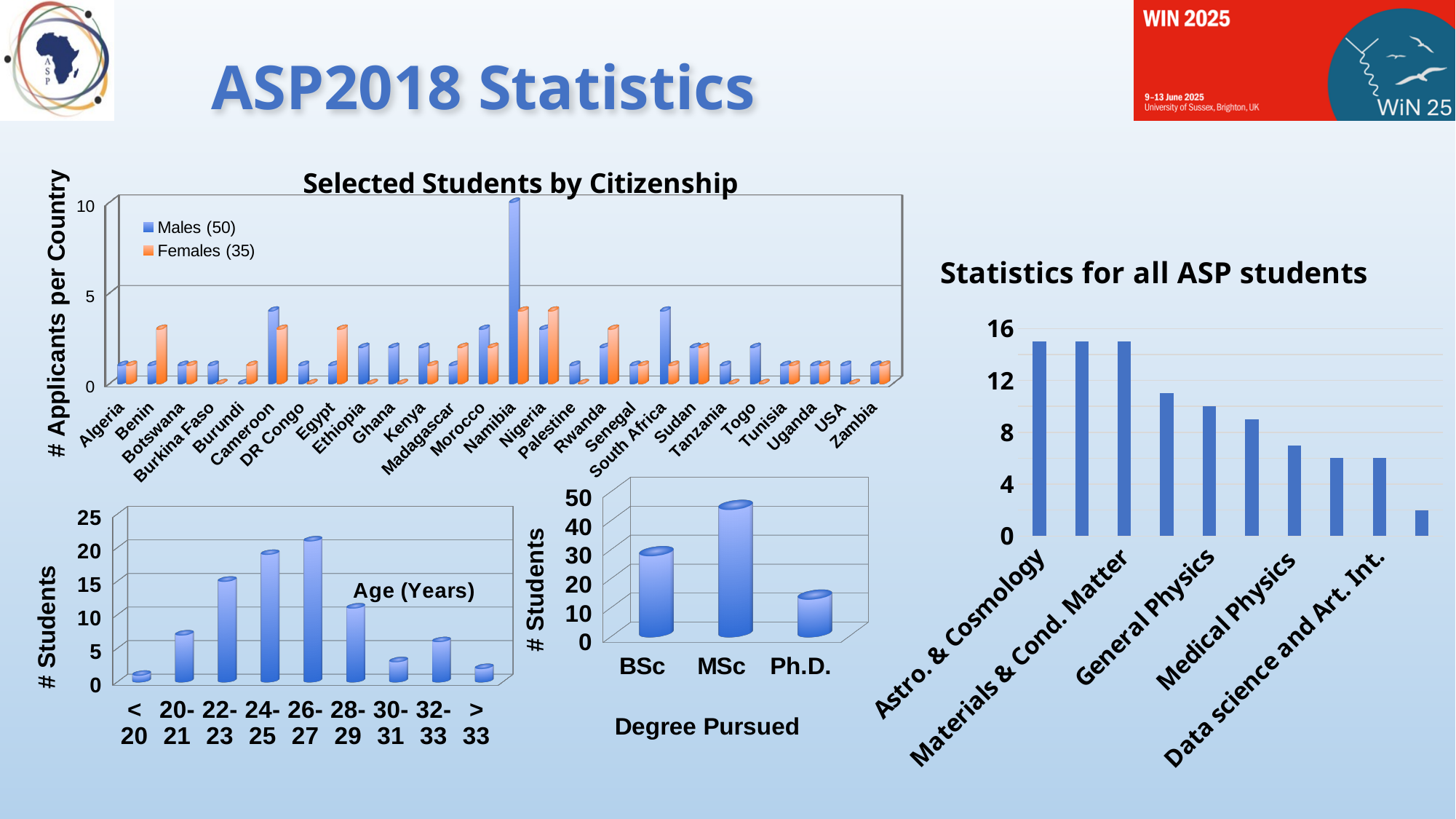
In the 'Degree Pursued' chart, which degree has the most students? MSc What kind of chart is 'Statistics for all ASP students'? bar chart In the age chart at the bottom left, which age group has the most students? 26-27 In 'Selected Students by Citizenship', what are the two legend entries? Males (50) and Females (35) What kind of chart is 'Selected Students by Citizenship'? bar chart In 'Selected Students by Citizenship', which country has the highest number of male applicants? Namibia In the 'Degree Pursued' chart, is the value for Ph.D. greater or less than 20? less How many series does the legend of 'Selected Students by Citizenship' list? 2 In 'Selected Students by Citizenship', is the Males value for Cameroon greater or less than 5? less In the age chart at the bottom left, how many age groups are shown on the x axis? 9 How many countries are shown on the x axis of 'Selected Students by Citizenship'? 26 In the age chart at the bottom left, is the value for 24-25 greater or less than 15? greater